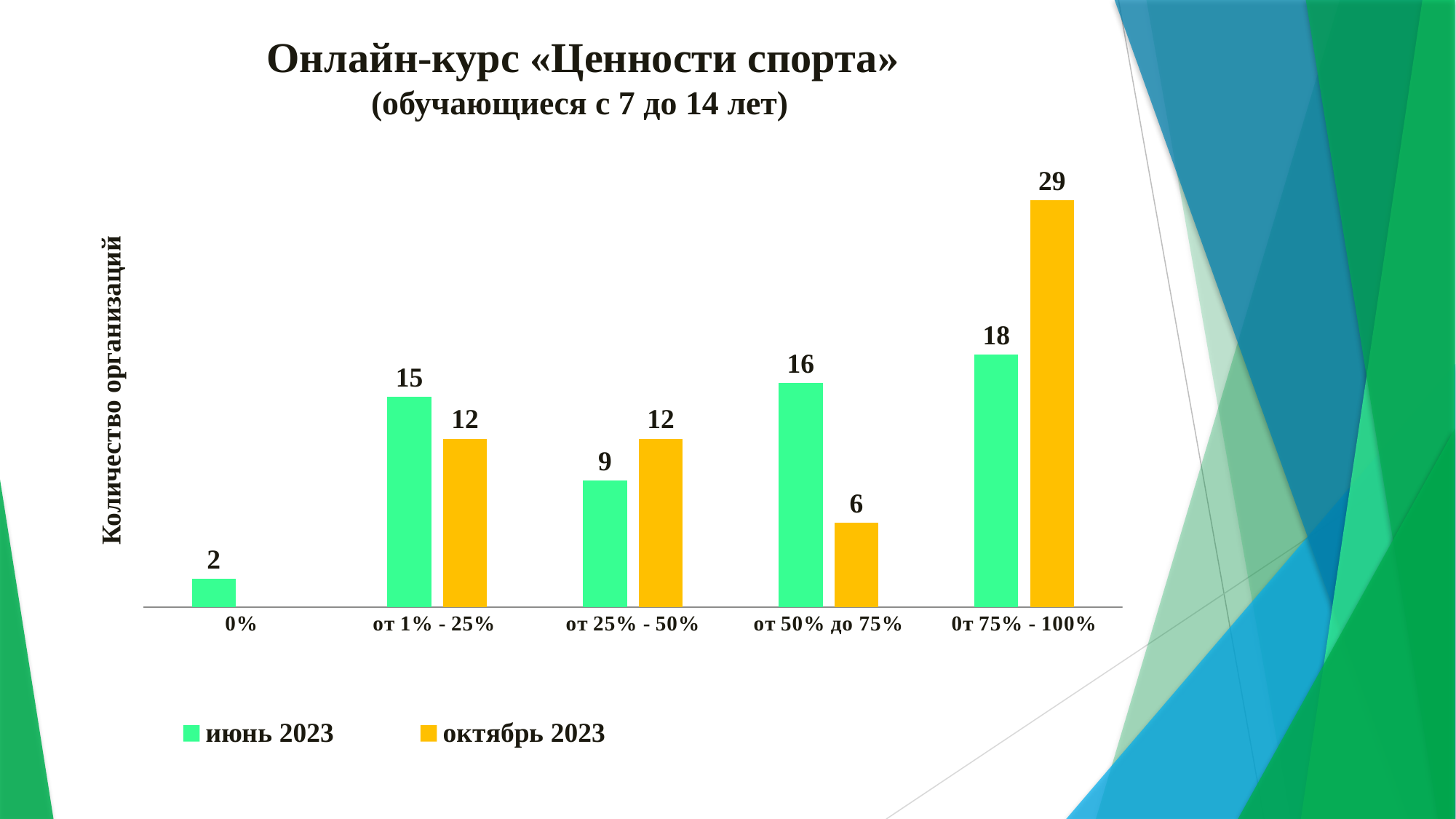
In the category от 50% до 75%, which series has the larger value, июнь 2023 or октябрь 2023? июнь 2023 How many series does the legend list? 2 What kind of chart is shown on the slide? bar chart How many categories are shown on the x axis? 5 What is the value for октябрь 2023 in the category от 50% до 75%? 6 What is the difference between the октябрь 2023 and июнь 2023 values in the category от 75% - 100%? 11 Which category has the lowest value for июнь 2023? 0% Which category has the highest value for октябрь 2023? от 75% - 100% What is the label of the vertical axis? Количество организаций What is the value for октябрь 2023 in the category от 75% - 100%? 29 What is the value for июнь 2023 in the category 0%? 2 What is the value for июнь 2023 in the category от 1% - 25%? 15